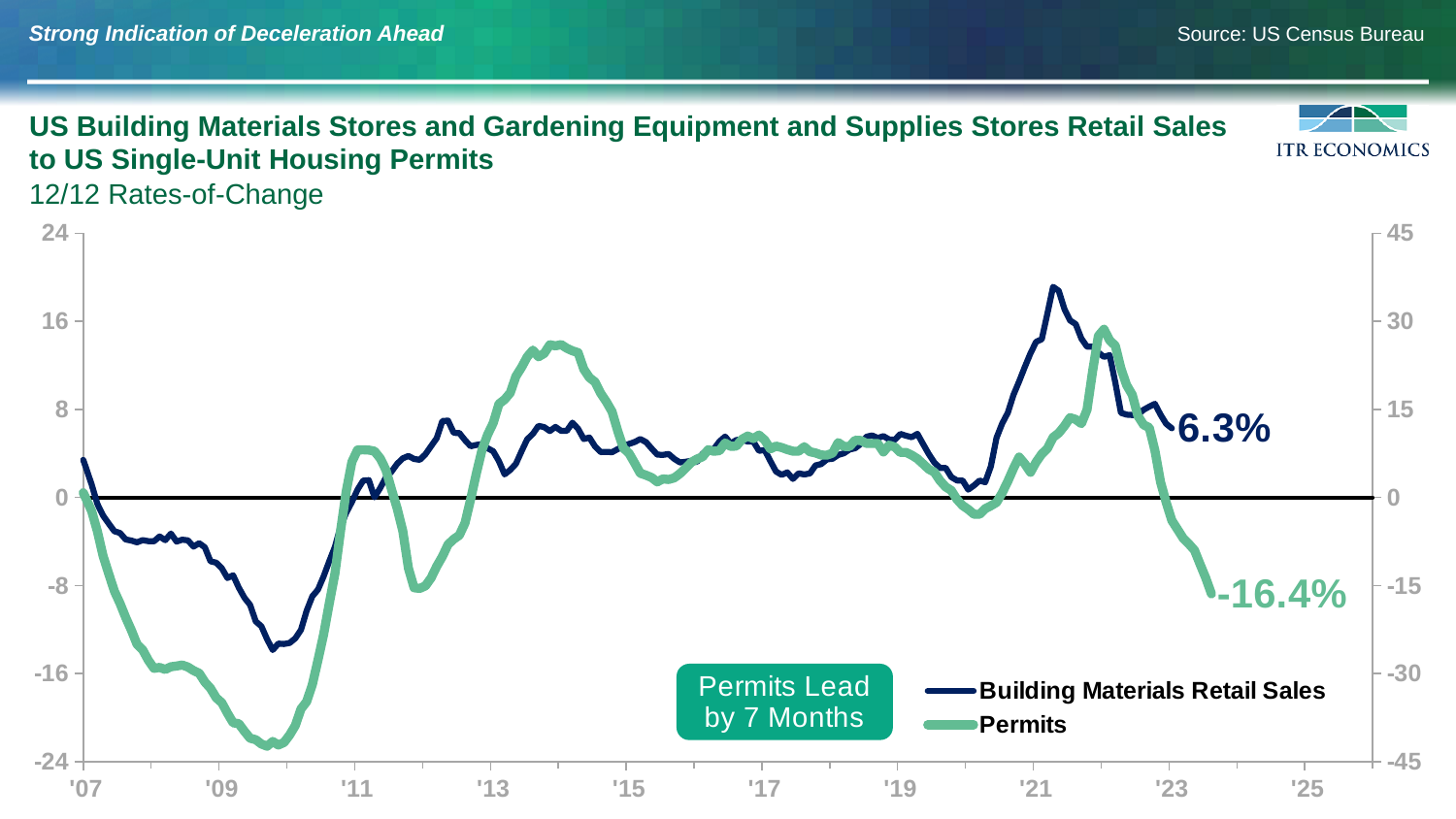
What kind of chart is shown on the slide? line chart What is the difference between the latest labeled values for Building Materials Retail Sales (6.3%) and Permits (-16.4%)? 22.7 percentage points Which series has the higher latest labeled value, Building Materials Retail Sales or Permits? Building Materials Retail Sales Does the Permits line rise or fall between '22 and '23? fall Is the lowest point of the Building Materials Retail Sales line around '10 greater or less than -8 on the left axis? less By how many months do Permits lead, according to the callout box? 7 months How many series does the legend list? 2 Is the peak of the Permits line around '22 greater or less than 15 on the right axis? greater What is the source cited for the chart data? US Census Bureau What is the latest labeled value for Building Materials Retail Sales? 6.3% What is the latest labeled value for Permits? -16.4% Is the latest value for Permits greater or less than 0? less